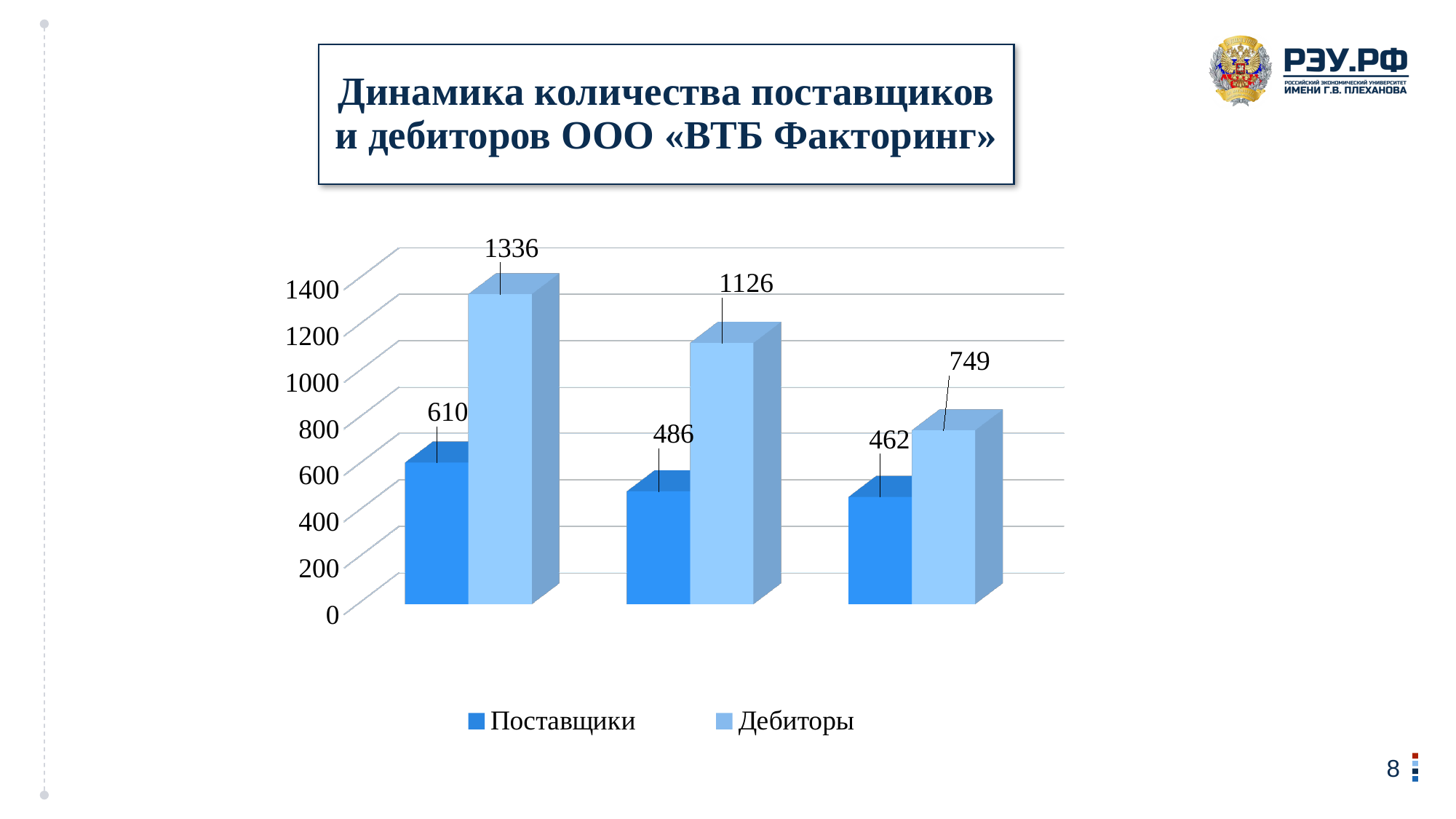
What is the value of Дебиторы in the third (rightmost) group of bars? 749 How many series does the legend list? 2 Do the Дебиторы values rise or fall from the left group to the right group? Fall What is the highest value shown for the Дебиторы series? 1336 What is the lowest value shown for the Поставщики series? 462 What is the difference between the Дебиторы value in the first group and the Дебиторы value in the third group? 587 In the first (leftmost) group, what is the difference between the Дебиторы value and the Поставщики value? 726 What is the value of Дебиторы in the second (middle) group of bars? 1126 Which is larger: the Поставщики value in the second group or the Дебиторы value in the third group? Дебиторы value in the third group How many groups of bars are shown in the chart? 3 What is the value of Поставщики in the first (leftmost) group of bars? 610 What type of chart is shown on the slide? Bar chart